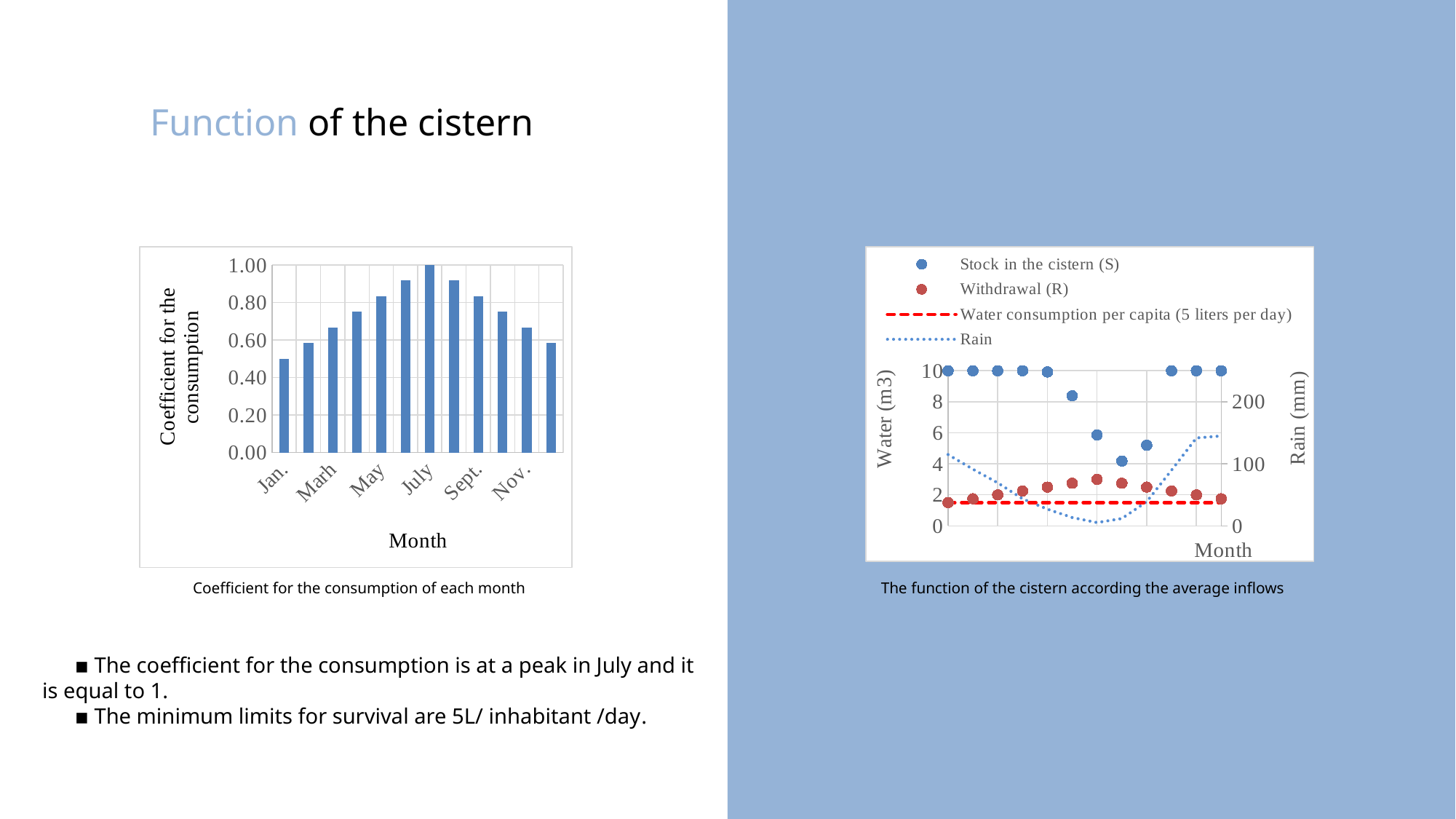
On the left chart (Coefficient for the consumption of each month), which is larger, the coefficient for May or for Jan.? May On the right chart (The function of the cistern according the average inflows), what is the label of the right-hand vertical axis? Rain (mm) On the left chart (Coefficient for the consumption of each month), what is the label of the vertical axis? Coefficient for the consumption On the left chart (Coefficient for the consumption of each month), how do the values change from Jan. to July? They rise On the left chart (Coefficient for the consumption of each month), which month has the highest coefficient? July On the left chart (Coefficient for the consumption of each month), is the value for May greater or less than 0.80? greater On the left chart (Coefficient for the consumption of each month), what kind of chart is shown? Bar chart On the left chart (Coefficient for the consumption of each month), is the value for Jan. greater or less than 0.60? less On the left chart (Coefficient for the consumption of each month), what is the coefficient for July? 1.00 On the left chart (Coefficient for the consumption of each month), which month has the lowest coefficient? Jan. On the left chart (Coefficient for the consumption of each month), how many bars are plotted? 12 On the right chart (The function of the cistern according the average inflows), how many series does the legend list? 4